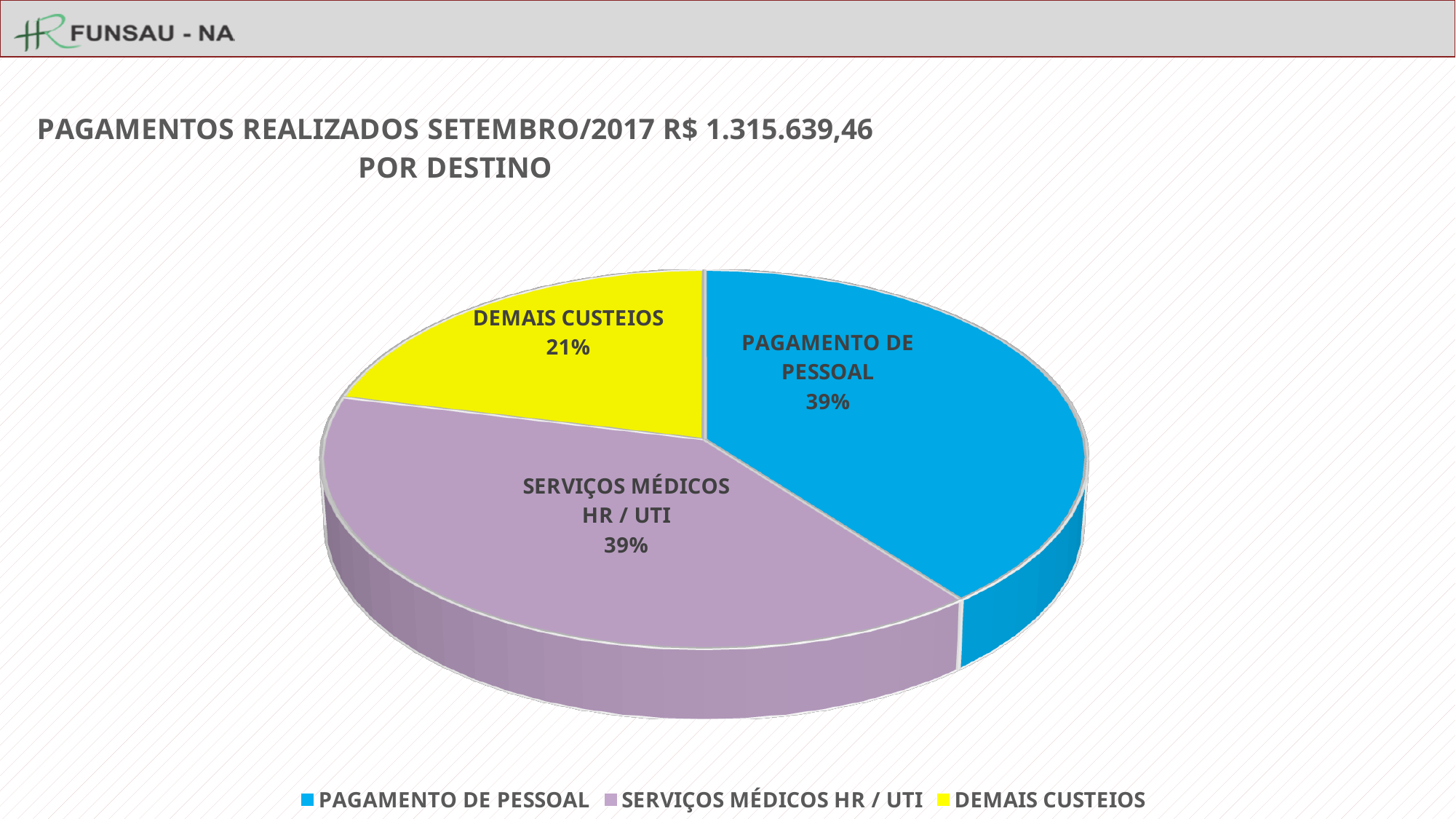
What kind of chart is shown on the slide? Pie chart What colour is the DEMAIS CUSTEIOS slice? Yellow What percentage is shown for DEMAIS CUSTEIOS? 21% How many slices does the pie chart have? 3 Which is larger, the slice for SERVIÇOS MÉDICOS HR / UTI or the slice for DEMAIS CUSTEIOS? SERVIÇOS MÉDICOS HR / UTI Which category has the smallest slice of the pie chart? DEMAIS CUSTEIOS What share of the pie chart is SERVIÇOS MÉDICOS HR / UTI? 39% What is the title of the chart? PAGAMENTOS REALIZADOS SETEMBRO/2017 R$ 1.315.639,46 POR DESTINO What is the difference in percentage points between PAGAMENTO DE PESSOAL and DEMAIS CUSTEIOS? 18 percentage points What percentage of the pie chart does PAGAMENTO DE PESSOAL represent? 39% How many entries does the legend list? 3